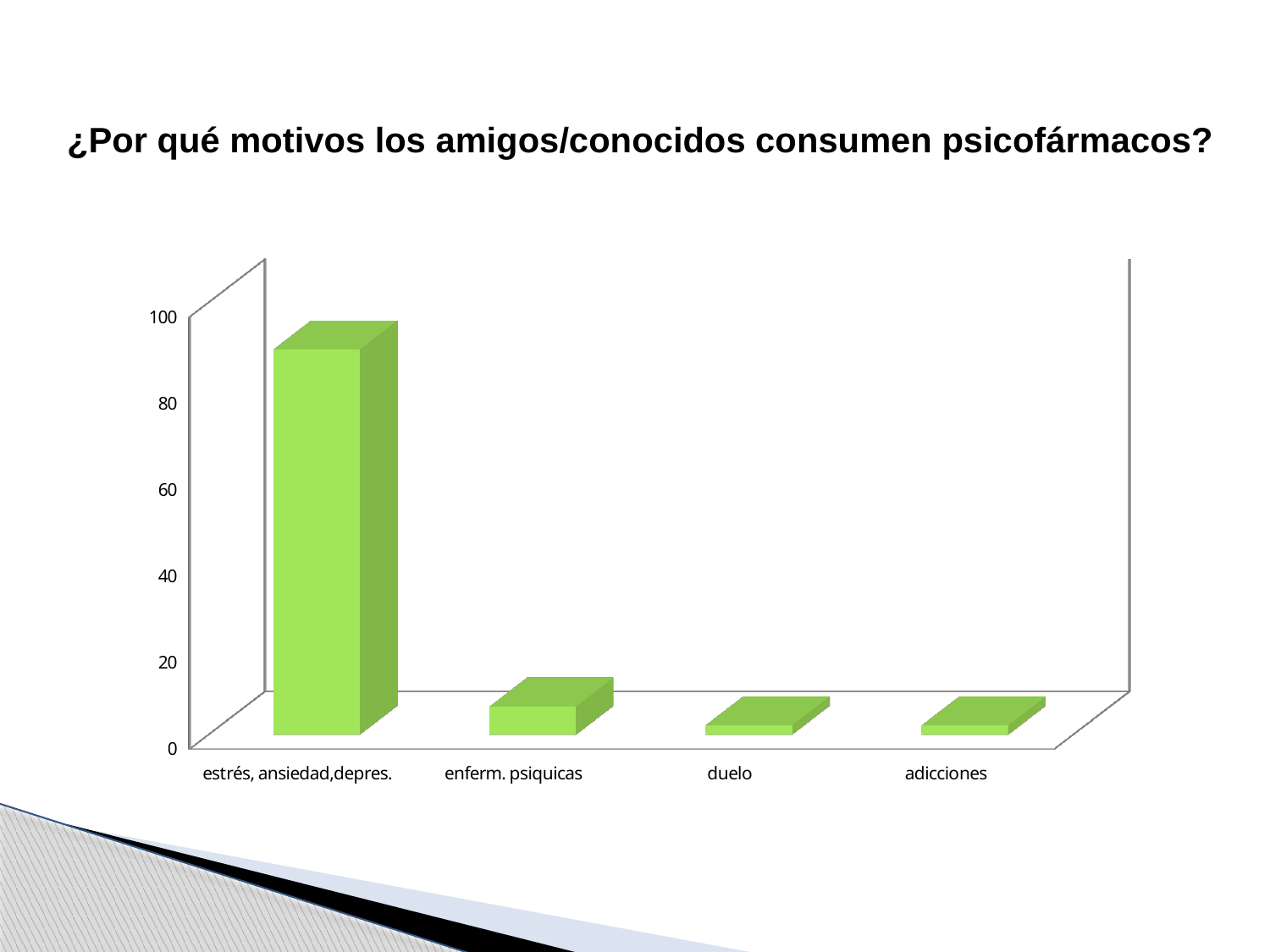
Is the value for adicciones greater or less than 20? less Which is larger, the value for estrés, ansiedad,depres. or the value for enferm. psiquicas? estrés, ansiedad,depres. Is the value for estrés, ansiedad,depres. greater or less than 80? greater Which category has the highest value in the chart? estrés, ansiedad,depres. Which is larger, the value for enferm. psiquicas or the value for duelo? enferm. psiquicas What is the title of the slide above the chart? ¿Por qué motivos los amigos/conocidos consumen psicofármacos? What is the highest tick value shown on the vertical axis of the chart? 100 How many categories are shown on the x axis of the chart? 4 What kind of chart is shown on the slide? bar chart Is the value for duelo greater or less than 20? less